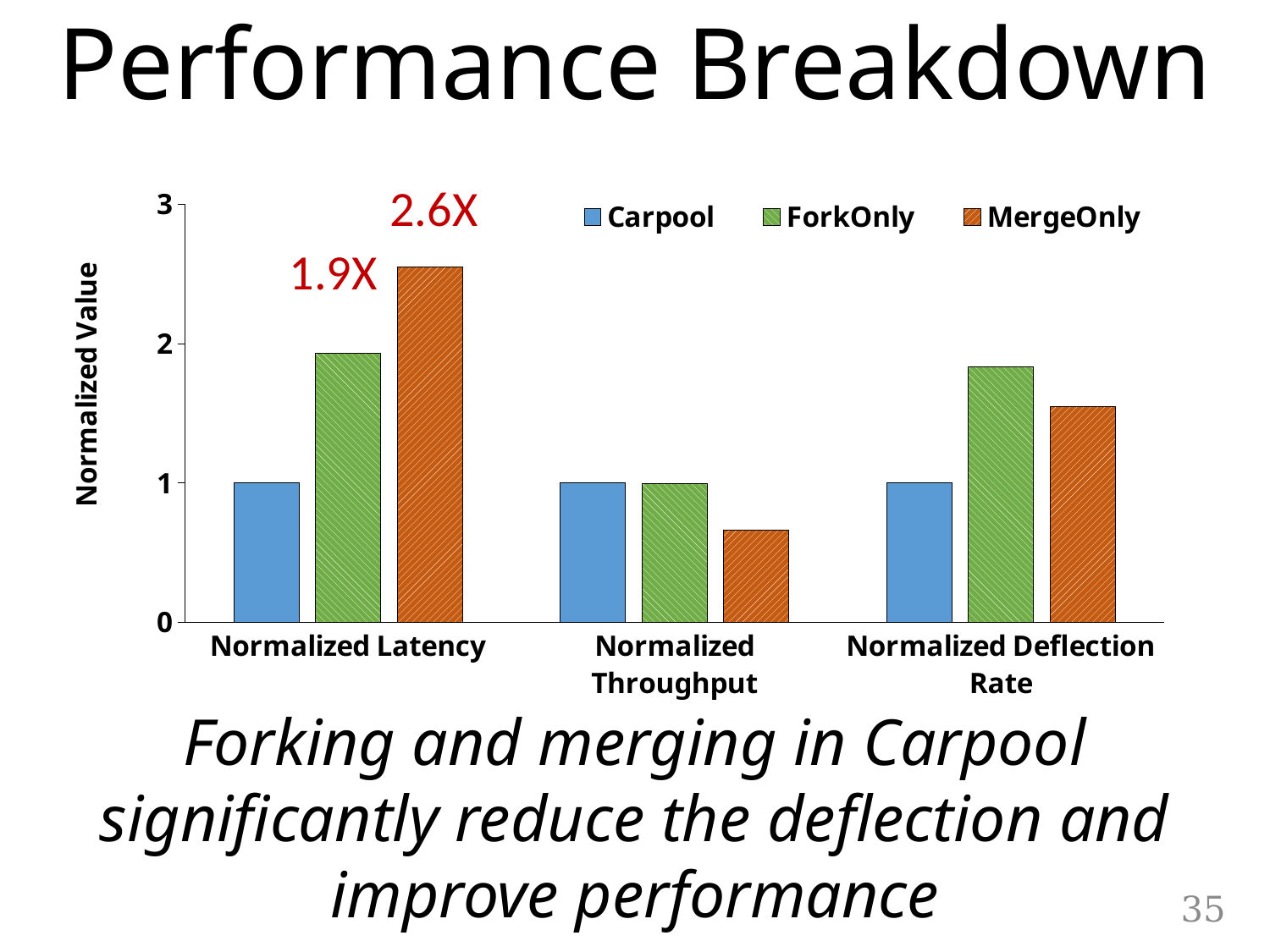
What is the label of the y axis? Normalized Value How many series does the legend list? 3 What is the annotated value for MergeOnly in the Normalized Latency category? 2.6X Which series has the highest value in the Normalized Deflection Rate category? ForkOnly Which series has the highest value in the Normalized Latency category? MergeOnly Which series has the lowest value in the Normalized Throughput category? MergeOnly Which is larger in the Normalized Deflection Rate category, ForkOnly or MergeOnly? ForkOnly What is the annotated value for ForkOnly in the Normalized Latency category? 1.9X What kind of chart is shown on the slide? bar chart What is the value for Carpool in the Normalized Throughput category? 1 How many categories are shown on the x axis? 3 Is the value for MergeOnly in the Normalized Throughput category greater or less than 1? less